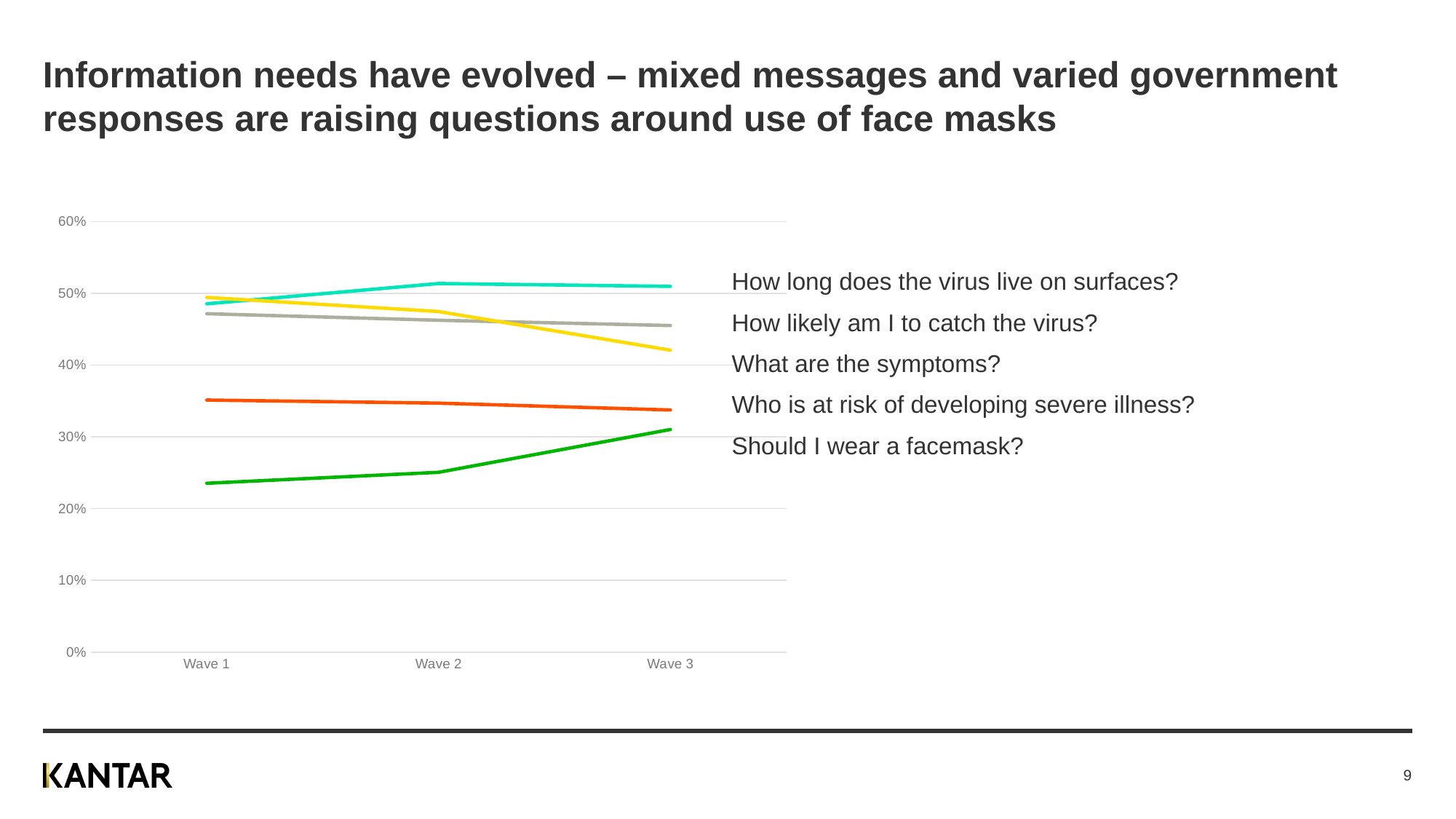
Does the yellow line rise or fall from Wave 1 to Wave 3? Falls At Wave 1, which is larger: the orange line or the green line? The orange line Which line has the highest value at Wave 3? The cyan line How many lines are plotted on the chart? 5 Is the value of the grey line at Wave 1 greater or less than 50%? less How many waves are shown on the x axis of the chart? 3 What is the highest value shown on the y axis of the chart? 60% Which line has the lowest value at Wave 3? The green line Does the green line rise or fall from Wave 1 to Wave 3? Rises What kind of chart is shown on the slide? Line chart Is the value of the green line at Wave 1 greater or less than 30%? less Is the value of the orange line at Wave 1 greater or less than 30%? greater